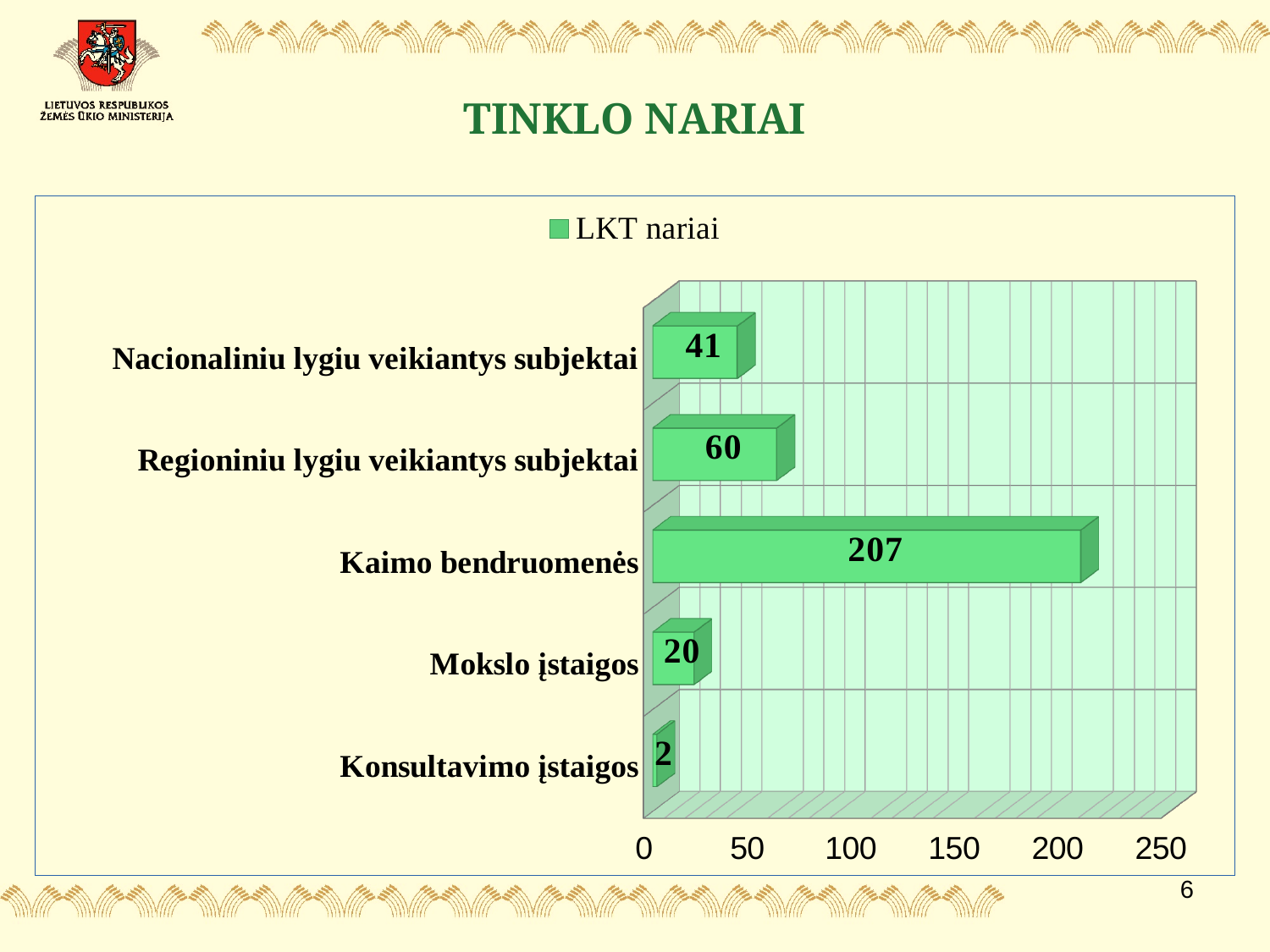
Which category has the lowest value? Konsultavimo įstaigos What is the value for Nacionaliniu lygiu veikiantys subjektai? 41 How many categories are shown in the chart? 5 Which category has the highest value? Kaimo bendruomenės What is the difference between the values for Regioniniu lygiu veikiantys subjektai and Nacionaliniu lygiu veikiantys subjektai? 19 What is the value for Mokslo įstaigos? 20 What is the name of the series shown in the legend? LKT nariai What is the value for Kaimo bendruomenės? 207 Is the value for Kaimo bendruomenės greater or less than 200? greater What kind of chart is shown on the slide? bar chart Which is larger, the value for Regioniniu lygiu veikiantys subjektai or the value for Mokslo įstaigos? Regioniniu lygiu veikiantys subjektai How many series does the legend list? 1